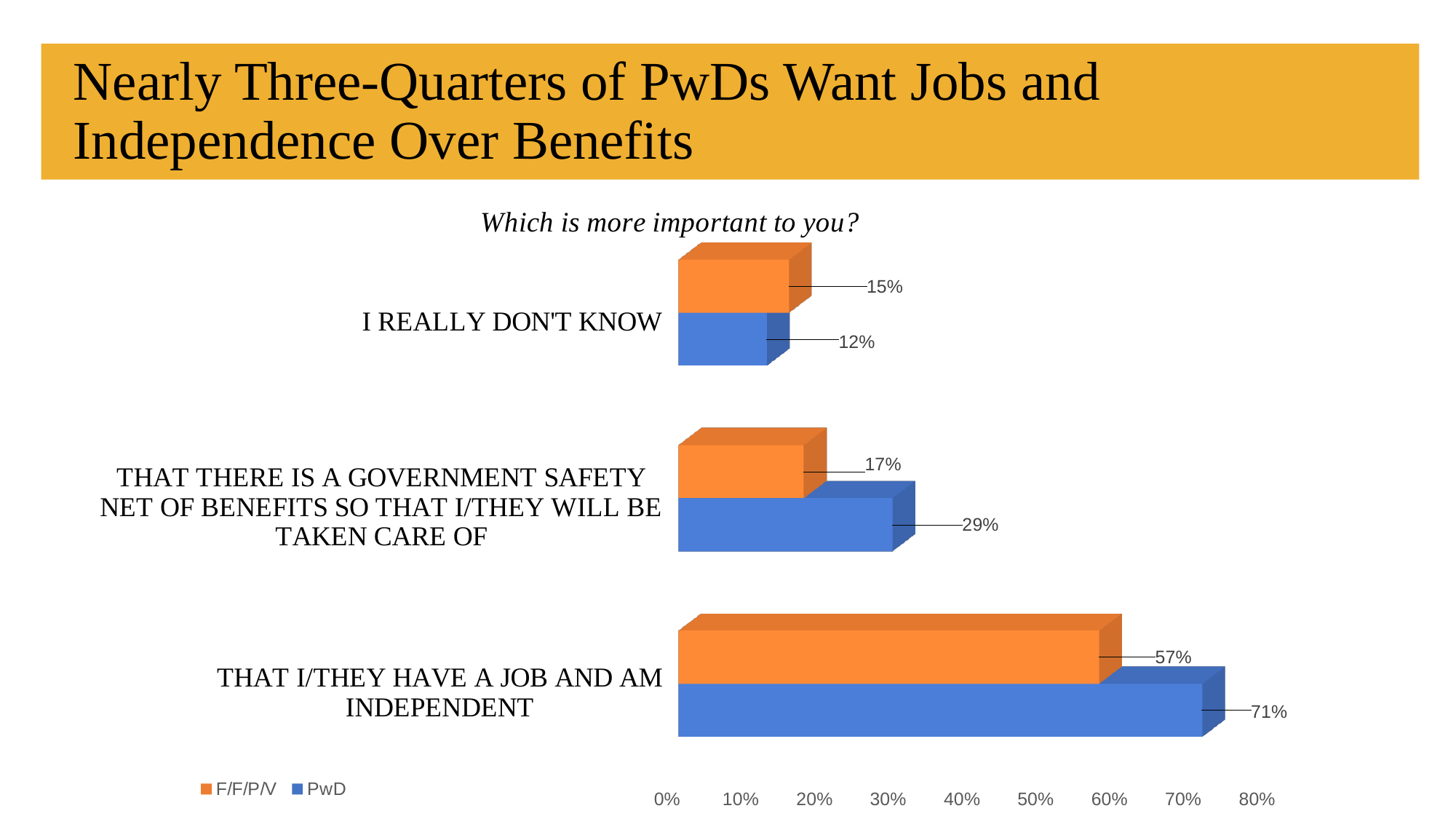
For "I really don't know", which series has the larger value, F/F/P/V or PwD? F/F/P/V What is the difference between the PwD and F/F/P/V values for "That I/they have a job and am independent"? 14% What type of chart is shown on the slide? Bar chart What percentage of PwD respondents chose "That I/they have a job and am independent"? 71% Is the PwD value for the government safety net category greater or less than 20%? greater Which category has the highest PwD value? That I/they have a job and am independent What is the F/F/P/V value for "I really don't know"? 15% Which category has the lowest PwD value? I really don't know How many categories are shown on the chart? 3 What percentage of F/F/P/V respondents chose "That there is a government safety net of benefits so that I/they will be taken care of"? 17% How many series does the legend list? 2 What is the difference between the PwD and F/F/P/V values for the government safety net category? 12%